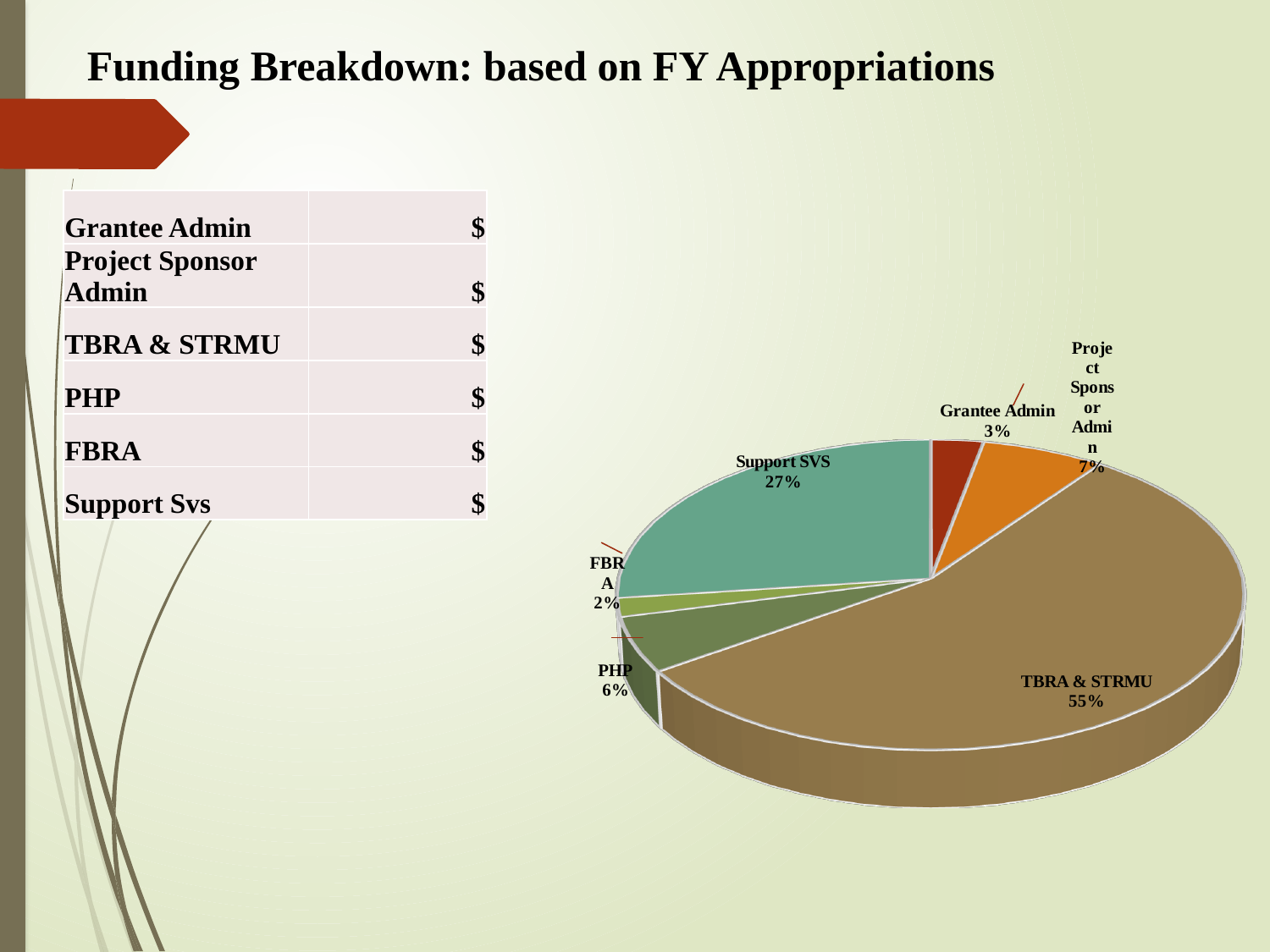
Which category has the largest slice of the pie? TBRA & STRMU What percentage is shown for Project Sponsor Admin? 7% What is the difference in percentage points between TBRA & STRMU and Support SVS? 28 What share of the pie does TBRA & STRMU represent? 55% What percentage is shown for FBRA? 2% Which is larger, the share for PHP or the share for Project Sponsor Admin? Project Sponsor Admin What percentage is shown for PHP? 6% Which category has the smallest slice of the pie? FBRA What share of the pie does Support SVS represent? 27% What percentage is shown for Grantee Admin? 3% How many slices does the pie chart have? 6 What kind of chart is shown on the slide? pie chart